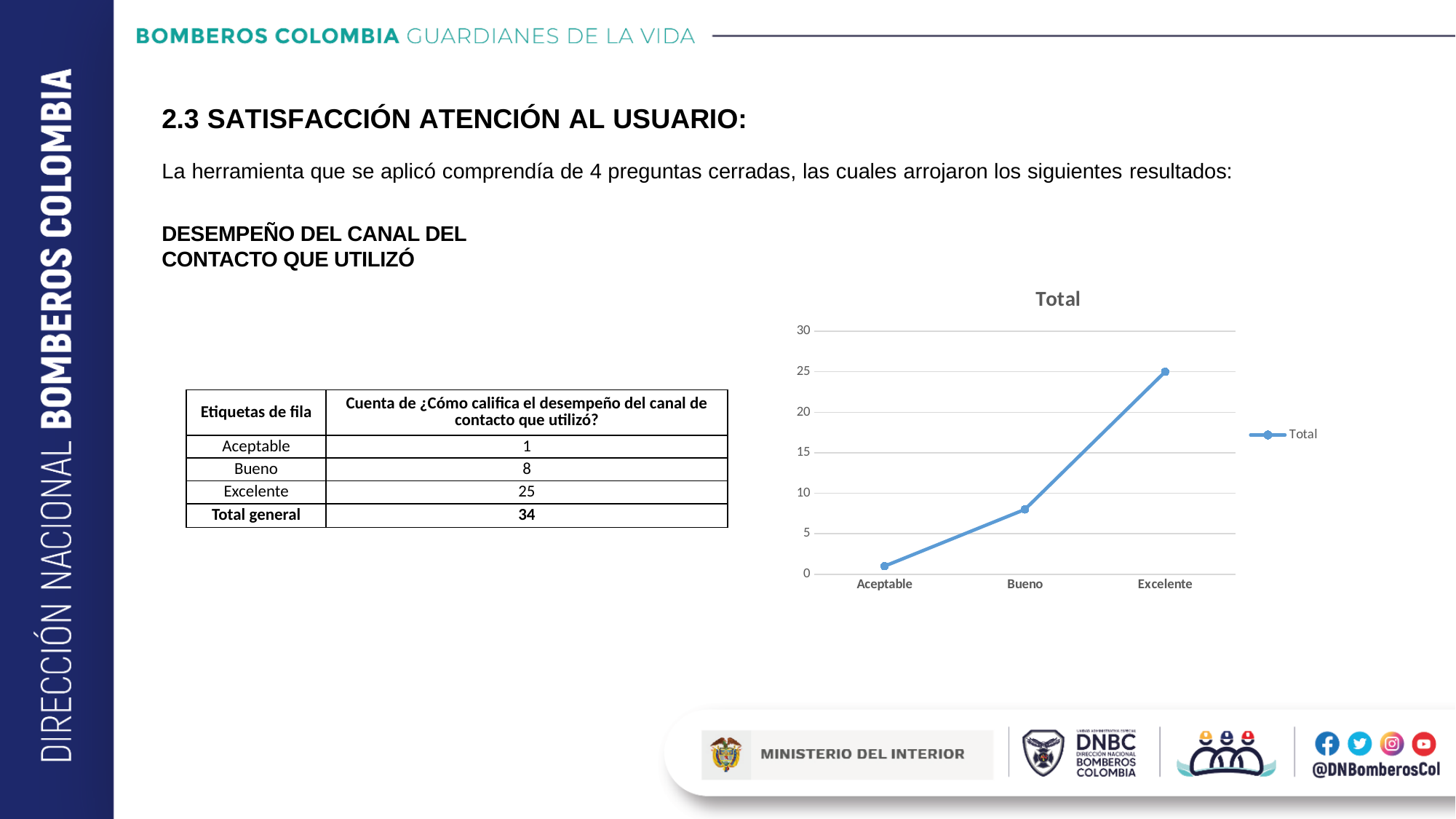
What is the value for Aceptable? 1 What kind of chart is shown on the slide? line chart What is the title of the chart? Total Do the values rise or fall from Aceptable to Excelente along the x axis? rise Which category has the highest value in the chart? Excelente How many series does the chart legend list? 1 How many categories are plotted on the x axis of the chart? 3 Which category has the lowest value in the chart? Aceptable Is the value for Bueno greater or less than 10? less What is the difference between the values for Excelente and Bueno? 17 What is the value for Bueno? 8 What is the value for Excelente? 25